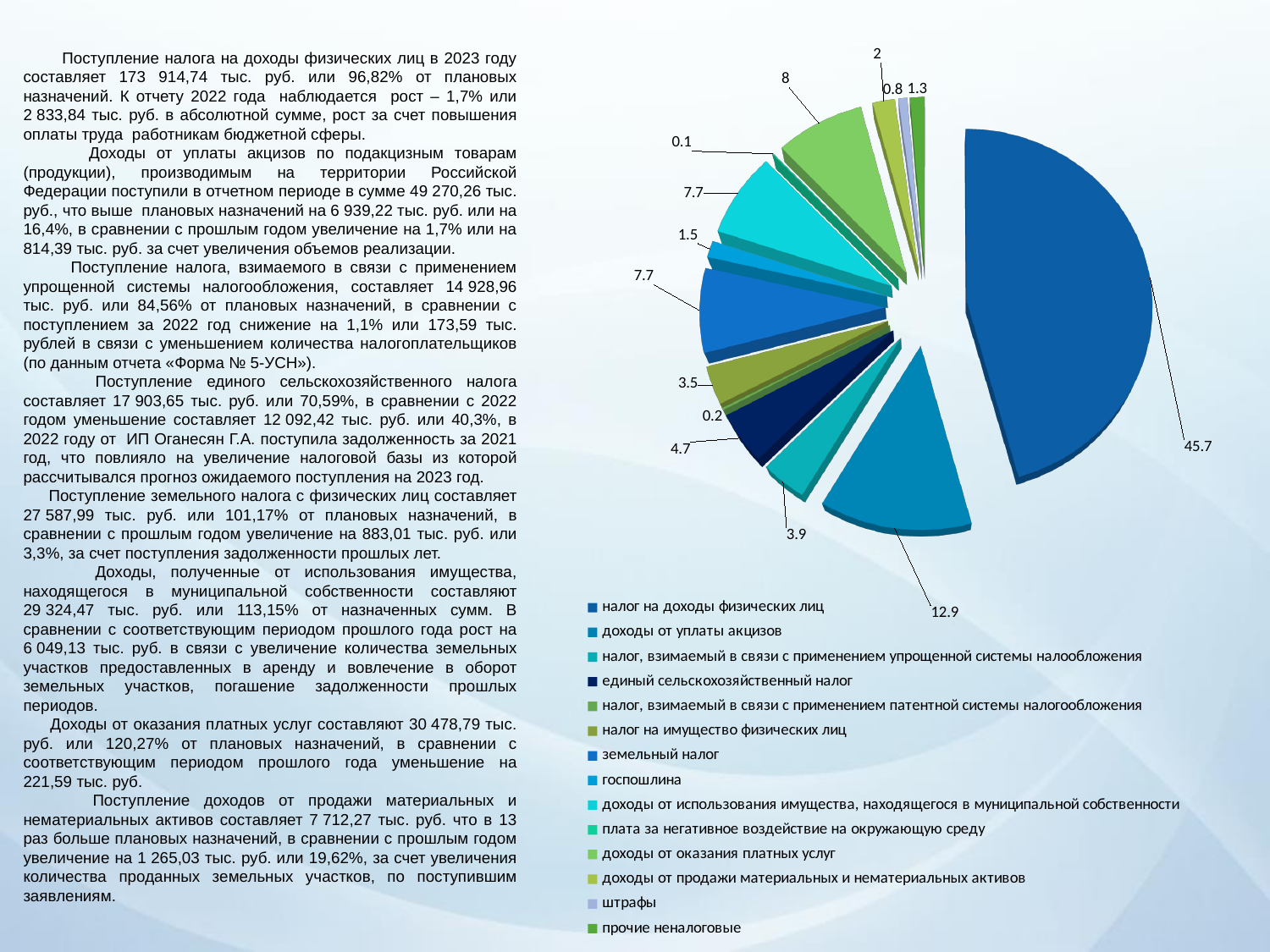
What is the value of the slice for штрафы? 0.8 How many entries does the chart legend list? 14 What is the value of the slice for доходы от уплаты акцизов? 12.9 What is the difference between the slice for налог на доходы физических лиц and the slice for доходы от уплаты акцизов? 32.8 What is the value of the slice for налог на доходы физических лиц? 45.7 Which is larger: the slice for налог на имущество физических лиц or the slice for единый сельскохозяйственный налог? единый сельскохозяйственный налог What is the value of the slice for единый сельскохозяйственный налог? 4.7 What is the value of the slice for доходы от продажи материальных и нематериальных активов? 2 Which category has the smallest slice in the pie chart? плата за негативное воздействие на окружающую среду What type of chart is shown on the slide? pie chart What is the value of the slice for доходы от оказания платных услуг? 8 Which category has the largest slice in the pie chart? налог на доходы физических лиц